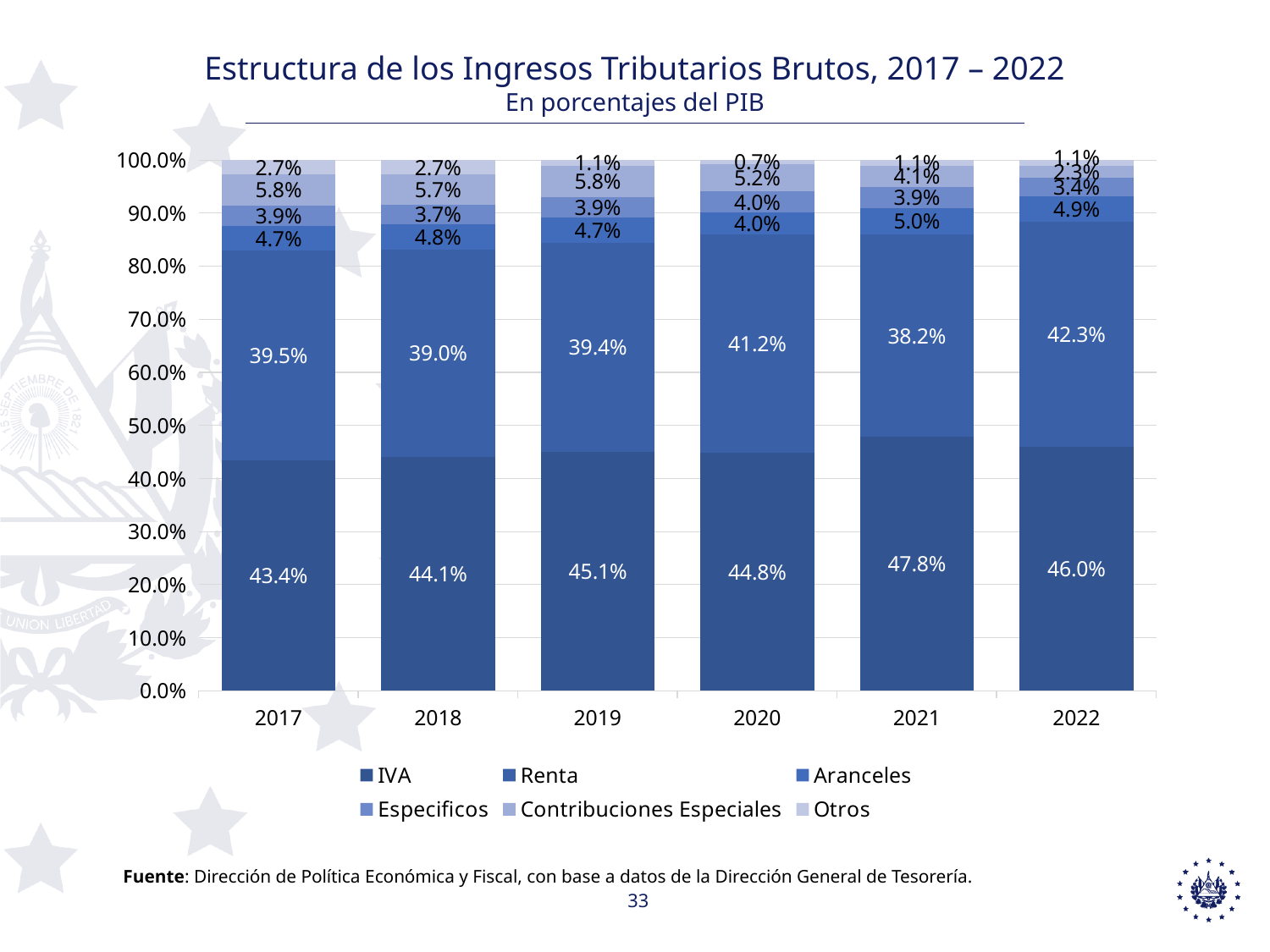
What is the Aranceles value for 2018? 4.8% In which year is the Renta share lowest? 2021 In which year is the IVA share highest? 2021 What is the difference between the IVA value in 2021 and in 2017? 4.4 percentage points What is the Otros value for 2017? 2.7% How many series does the legend list? 6 Which year has the larger Renta value, 2019 or 2020? 2020 What kind of chart is shown on the slide? Stacked bar chart What is the IVA value for 2021? 47.8% What is the Renta value for 2022? 42.3% How many years are shown on the x axis? 6 Is the IVA value for 2019 greater or less than 40.0%? greater